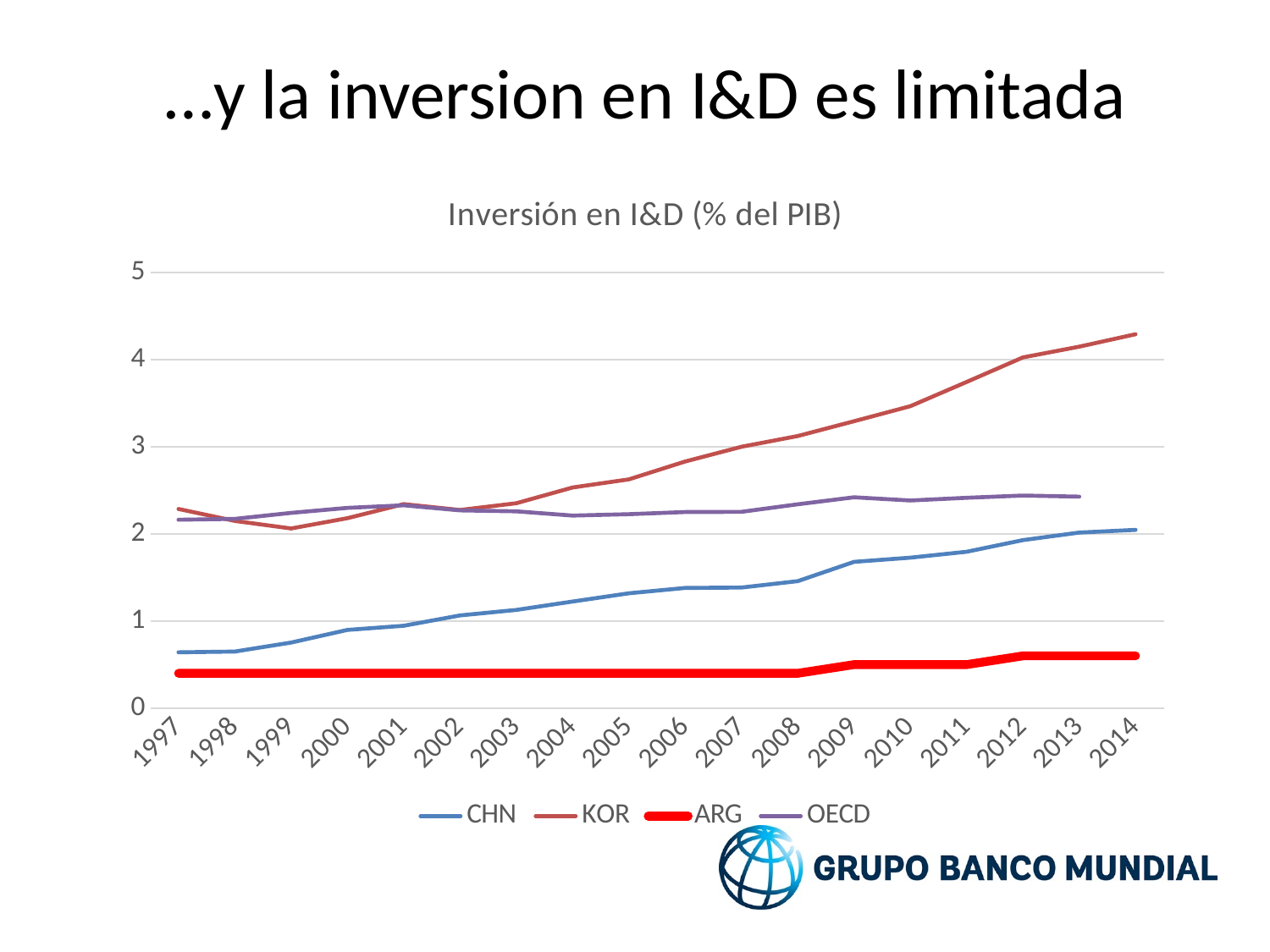
How many series does the legend list? 4 Does the CHN series rise or fall from 1997 to 2014? rise Is the value for CHN in 1997 greater or less than 1? less Which series has the lowest value in 2014? ARG What kind of chart is shown on the slide? line chart Is the value for KOR in 2014 greater or less than 4? greater How many years are shown along the x axis? 18 What is the title of the chart? Inversión en I&D (% del PIB) In 2005, which is larger: the value for OECD or the value for CHN? OECD Which series has the highest value in 2014? KOR Does the KOR series rise or fall from 1999 to 2014? rise Is the value for ARG in 2014 greater or less than 1? less